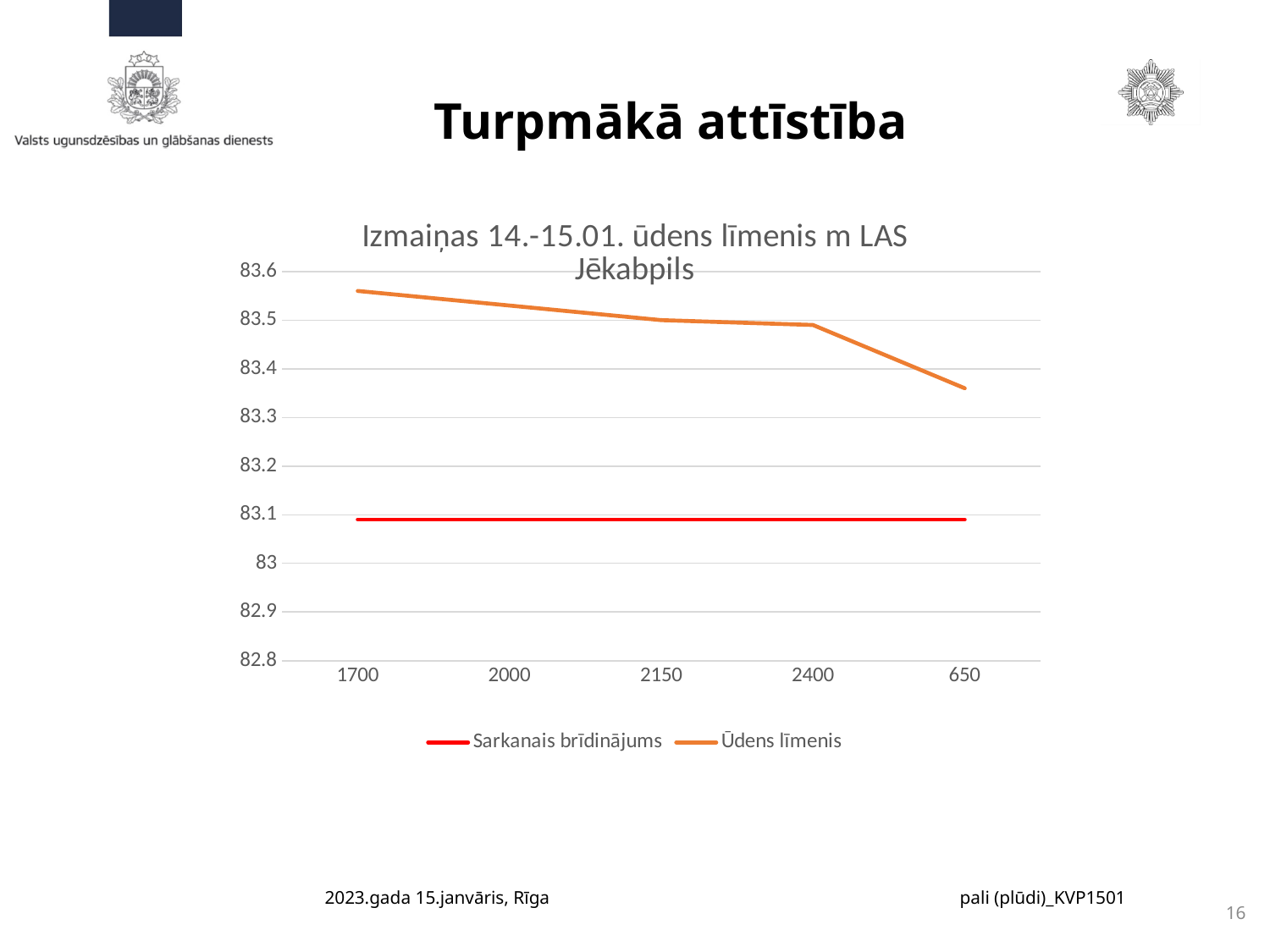
How many series does the legend list? 2 Is the Ūdens līmenis value at 650 greater or less than 83.4? less At which x-axis category is the Ūdens līmenis value highest? 1700 Is the Sarkanais brīdinājums line greater or less than 83.2? less Does the Ūdens līmenis series rise or fall from left to right along the x axis? fall What kind of chart is shown on the slide? line chart What is the title of the chart? Izmaiņas 14.-15.01. ūdens līmenis m LAS Jēkabpils At which x-axis category is the Ūdens līmenis value lowest? 650 Is the Ūdens līmenis value at 1700 greater or less than 83.5? greater What colour is the Sarkanais brīdinājums line? red At 650, which series has the larger value, Ūdens līmenis or Sarkanais brīdinājums? Ūdens līmenis How many points are plotted along the x axis for the Ūdens līmenis series? 5